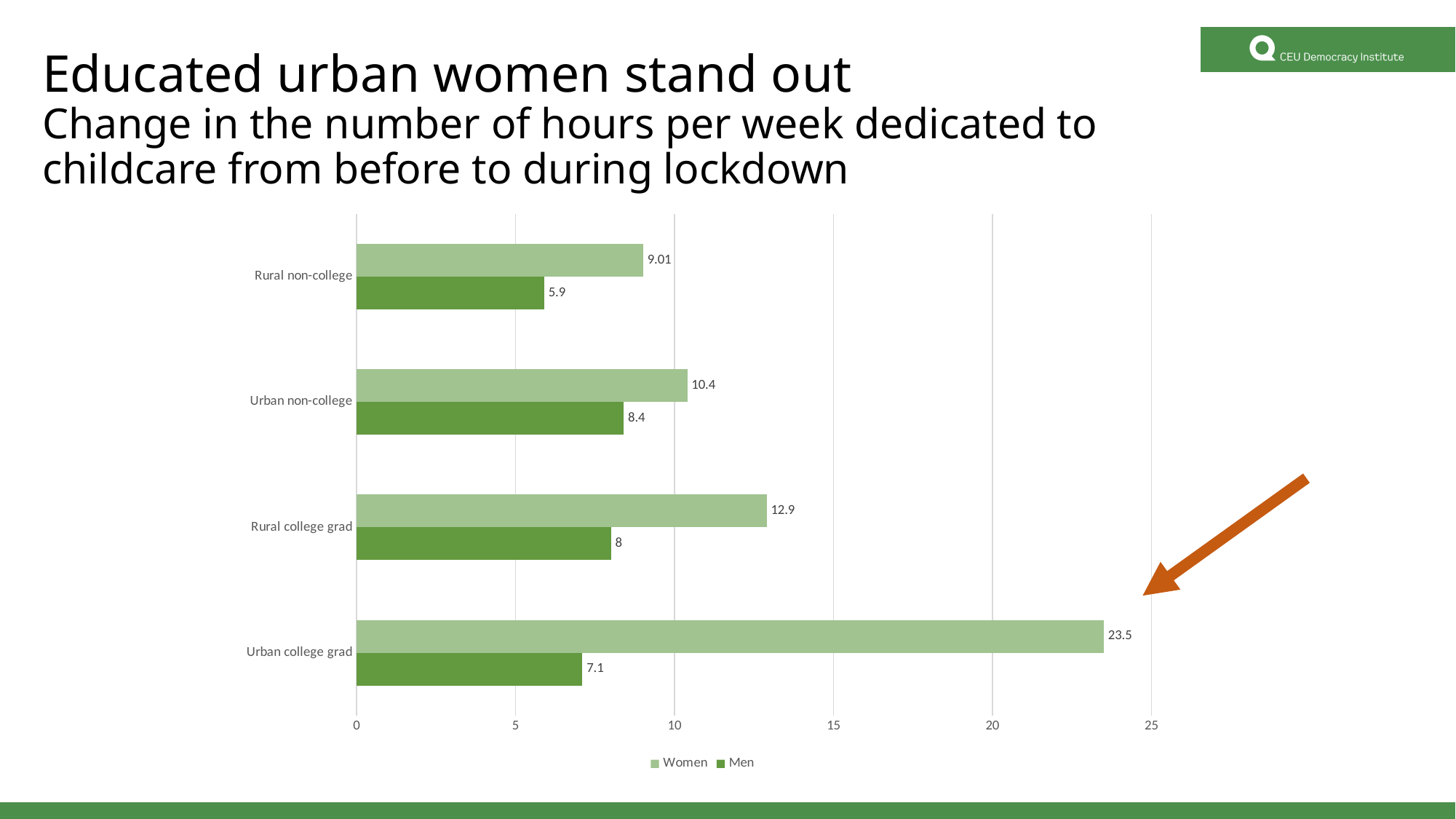
What is the value for Women in the Rural college grad category? 12.9 What is the value for Women in the Urban college grad category? 23.5 Which category has the highest value for Women? Urban college grad What is the value for Men in the Urban non-college category? 8.4 Which category has the lowest value for Men? Rural non-college What kind of chart is shown on the slide? Bar chart Which is larger: the Men value for Urban non-college or the Men value for Rural college grad? Urban non-college How many series does the legend list? 2 What is the difference between the Women and Men values for Urban college grad? 16.4 Is the value for Women in the Urban non-college category greater or less than 10? greater What is the value for Men in the Rural non-college category? 5.9 How many categories are shown on the chart? 4